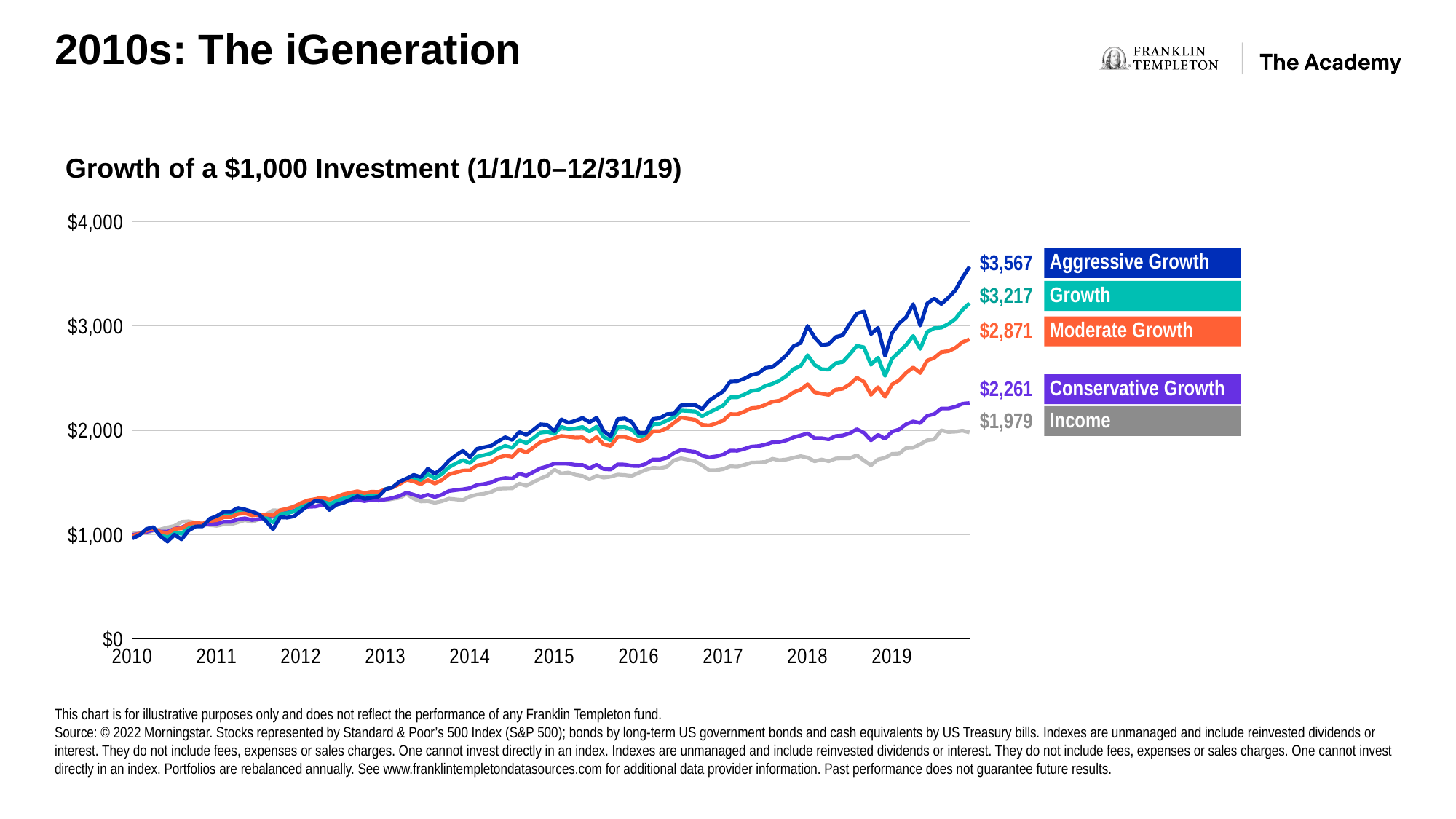
What kind of chart is shown on the slide? Line chart Do the portfolio values generally rise or fall from 2010 to 2019? Rise Which portfolio has the highest ending value? Aggressive Growth How many portfolios are plotted on the chart? 5 Is the ending value of the Conservative Growth portfolio greater or less than $2,000? greater Which has a larger ending value, Growth or Moderate Growth? Growth What is the difference between the ending values of the Aggressive Growth and Growth portfolios? $350 Which portfolio has the lowest ending value? Income What is the difference between the ending values of the Conservative Growth and Income portfolios? $282 What is the ending value of the Income portfolio? $1,979 What is the ending value of the Moderate Growth portfolio? $2,871 What is the ending value of the Aggressive Growth portfolio at the end of 2019? $3,567